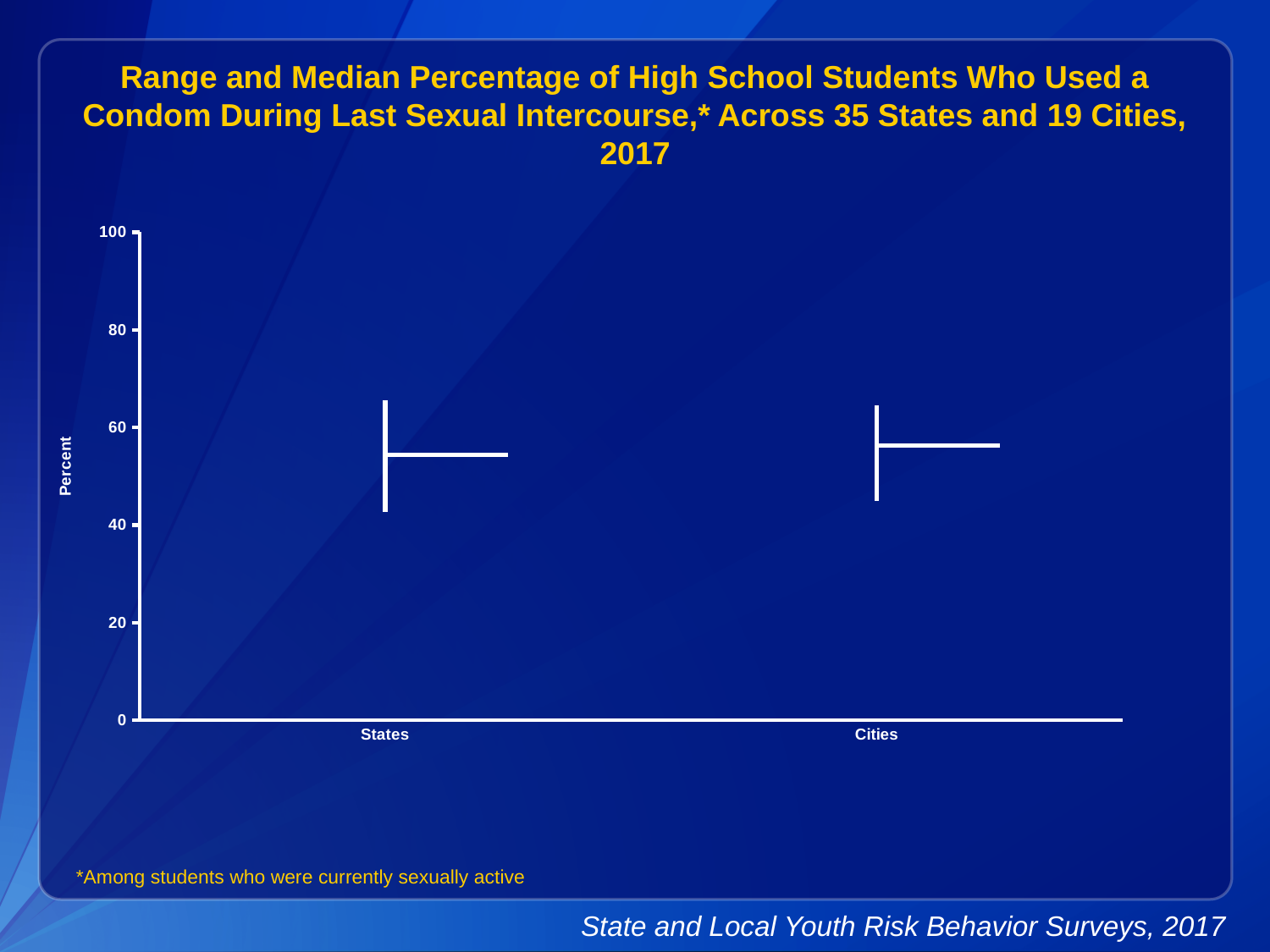
Is the median value for Cities greater or less than 60? less Is the median value for States greater or less than 60? less How many categories are shown on the x axis of the chart? 2 Is the bottom of the range for Cities greater or less than 60? less What is the label of the y axis? Percent What are the two categories shown on the x axis? States and Cities What is the highest value shown on the y axis? 100